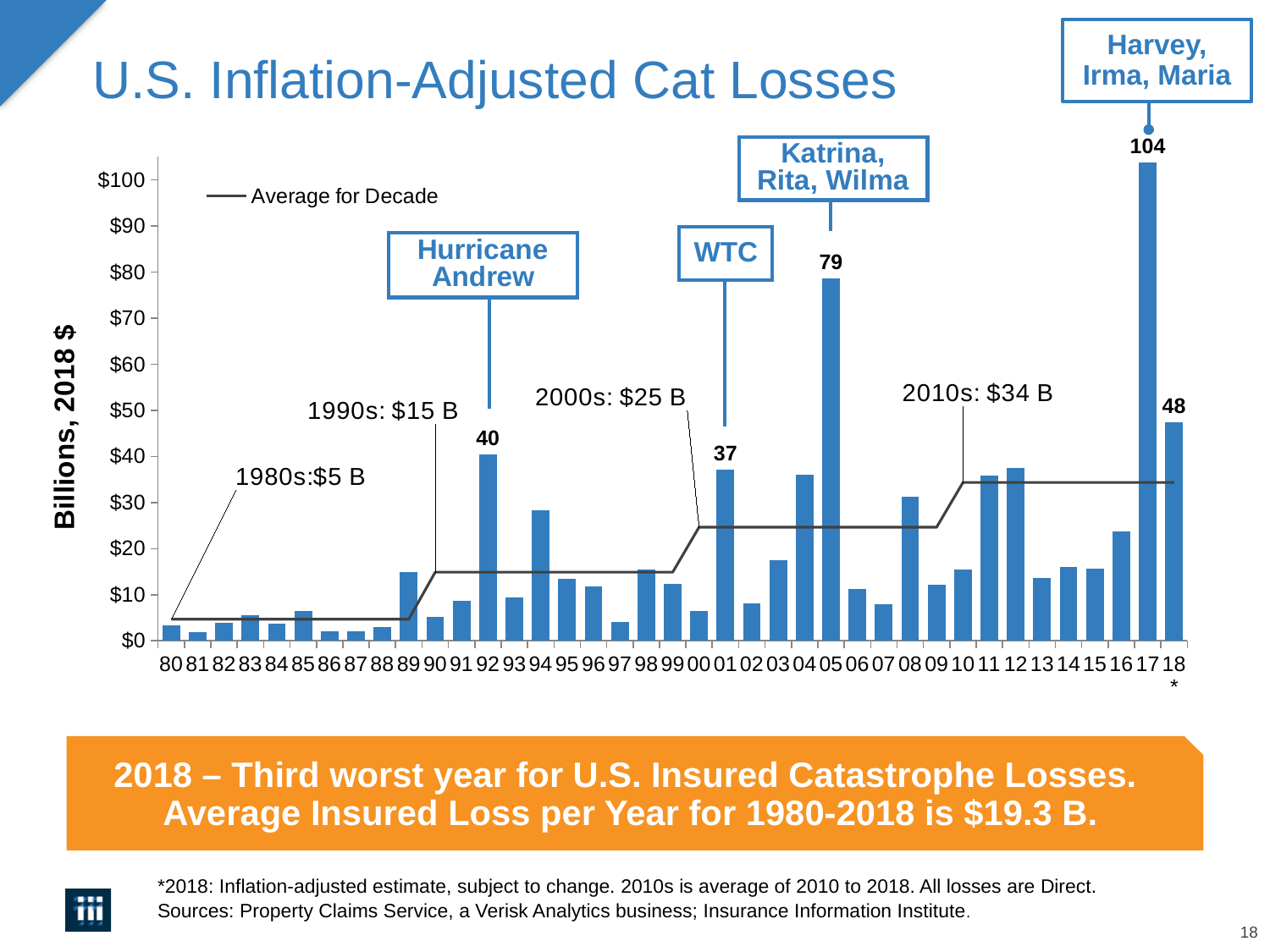
What is the value for 2017 (labeled 17) in the U.S. Inflation-Adjusted Cat Losses chart? 104 What is the value for 2005 (labeled 05) in the chart? 79 Is the value for 2004 (labeled 04) greater or less than $30? greater What is the average for the 2000s decade shown on the chart? $25 B What is the value for 1992 (labeled 92) in the chart? 40 Which year has the larger value, 2005 or 2001? 2005 What kind of chart is used to show the cat losses? bar chart What is the difference between the values for 2005 and 2001 in the chart? 42 Which year has the highest cat losses in the chart? 17 How many years (bars) are shown in the chart? 39 What is the difference between the values for 2017 and 2018 in the chart? 56 What is the value for 2001 (labeled 01) in the chart? 37